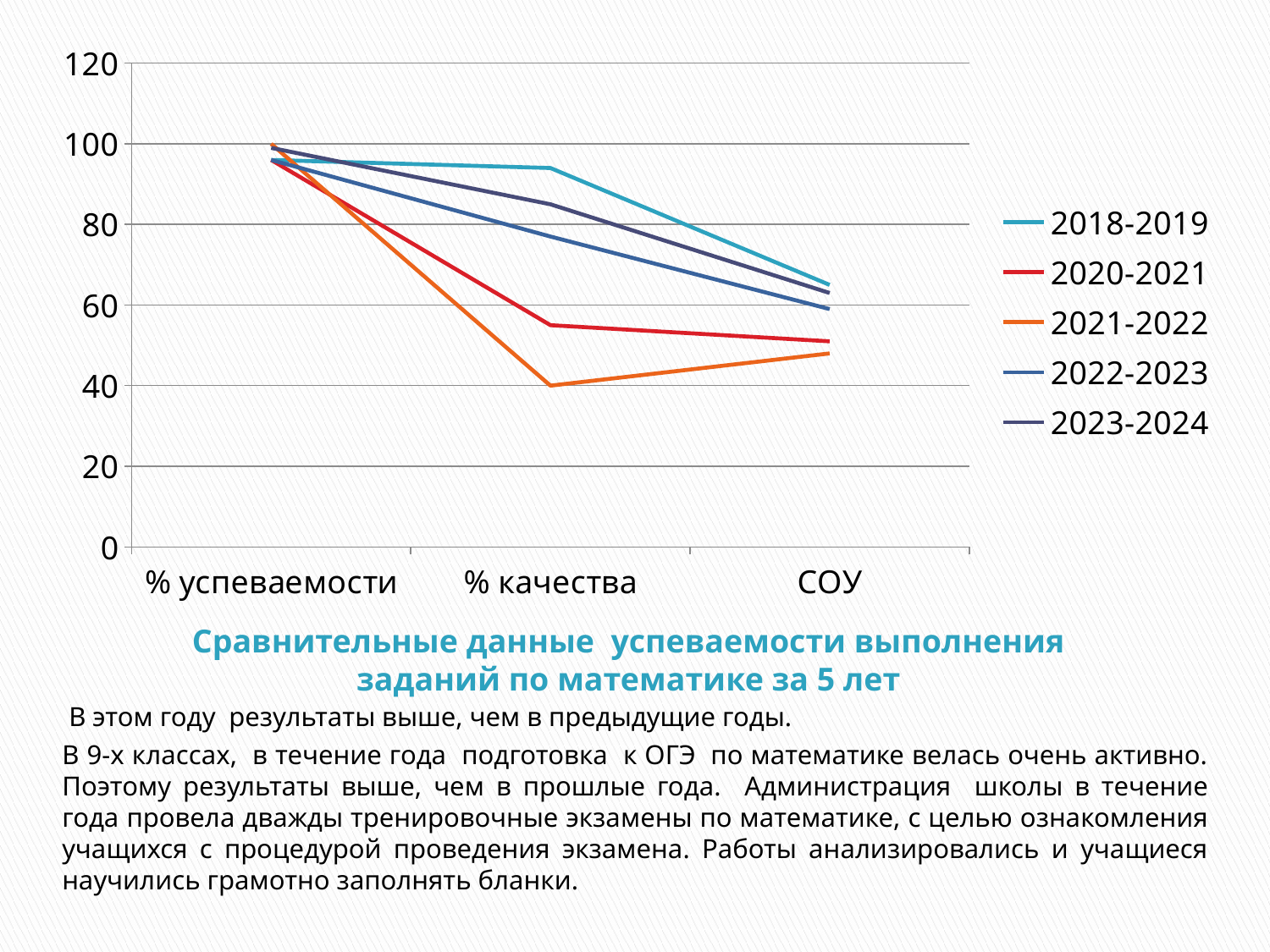
Which series has the lowest value for % качества? 2021-2022 Do the values of the 2018-2019 series rise or fall from % успеваемости to СОУ? fall How many series does the legend list? 5 Is the value of the 2021-2022 series for СОУ greater or less than 60? less Is the value of the 2023-2024 series for % качества greater or less than 80? greater What is the value of the 2021-2022 series for % качества? 40 What is the title shown below the chart? Сравнительные данные успеваемости выполнения заданий по математике за 5 лет For СОУ, which is larger: the 2018-2019 series or the 2021-2022 series? 2018-2019 Is the value of the 2018-2019 series for СОУ greater or less than 60? greater Which series has the highest value for % качества? 2018-2019 What kind of chart is shown on the slide? line chart How many categories are shown on the x axis? 3